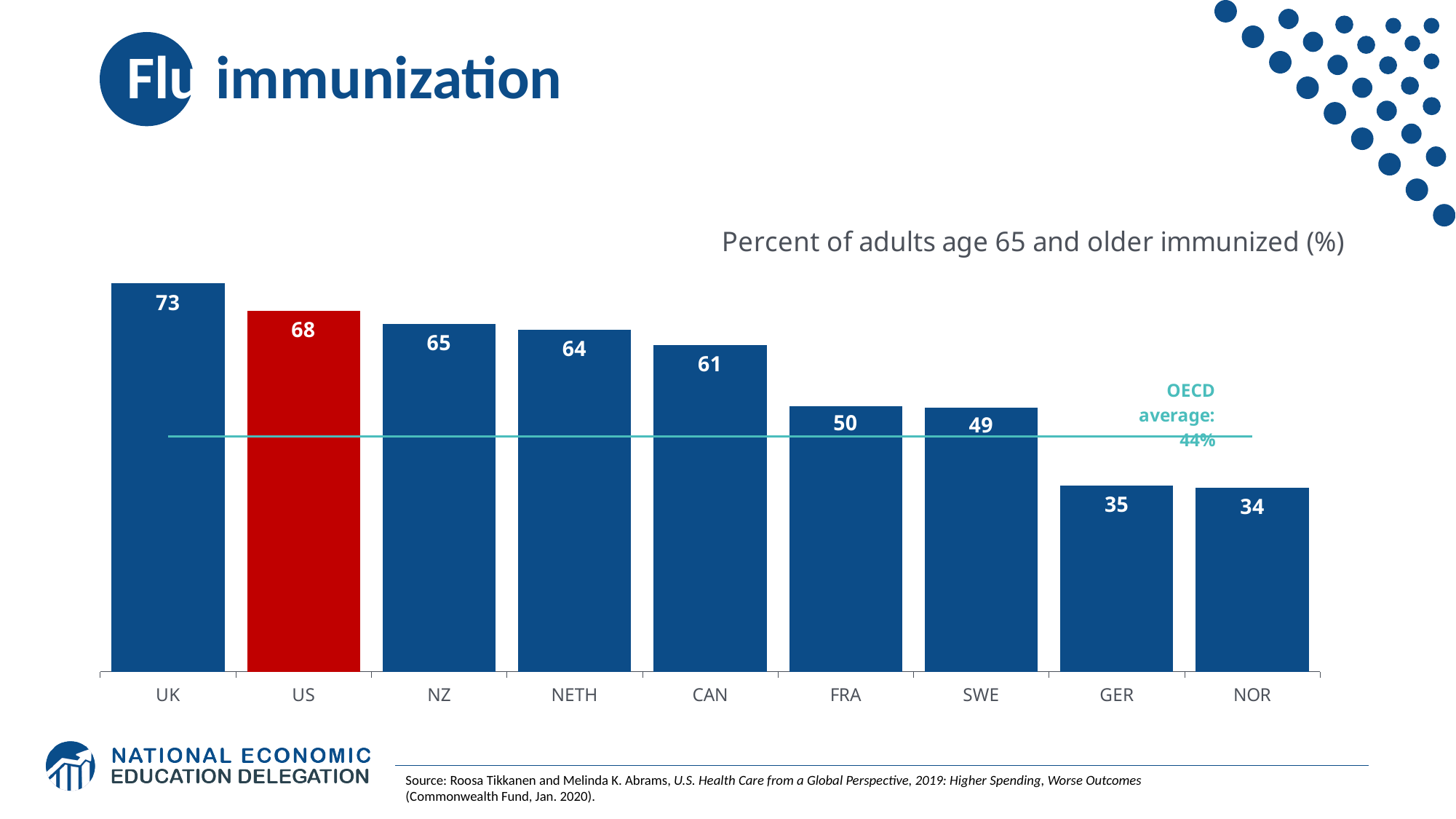
What is the value for CAN? 61 Which is larger, the value for NZ or the value for FRA? NZ Which country has the highest value? UK Do the values rise or fall from left to right across the countries? fall What is the difference between the values for UK and US? 5 What is the value for the US? 68 What is the value for GER? 35 What OECD average is marked by the horizontal line on the chart? 44% How many countries are shown in the chart? 9 What kind of chart is shown on the slide? bar chart What is the difference between the values for NETH and SWE? 15 Which country has the lowest value? NOR